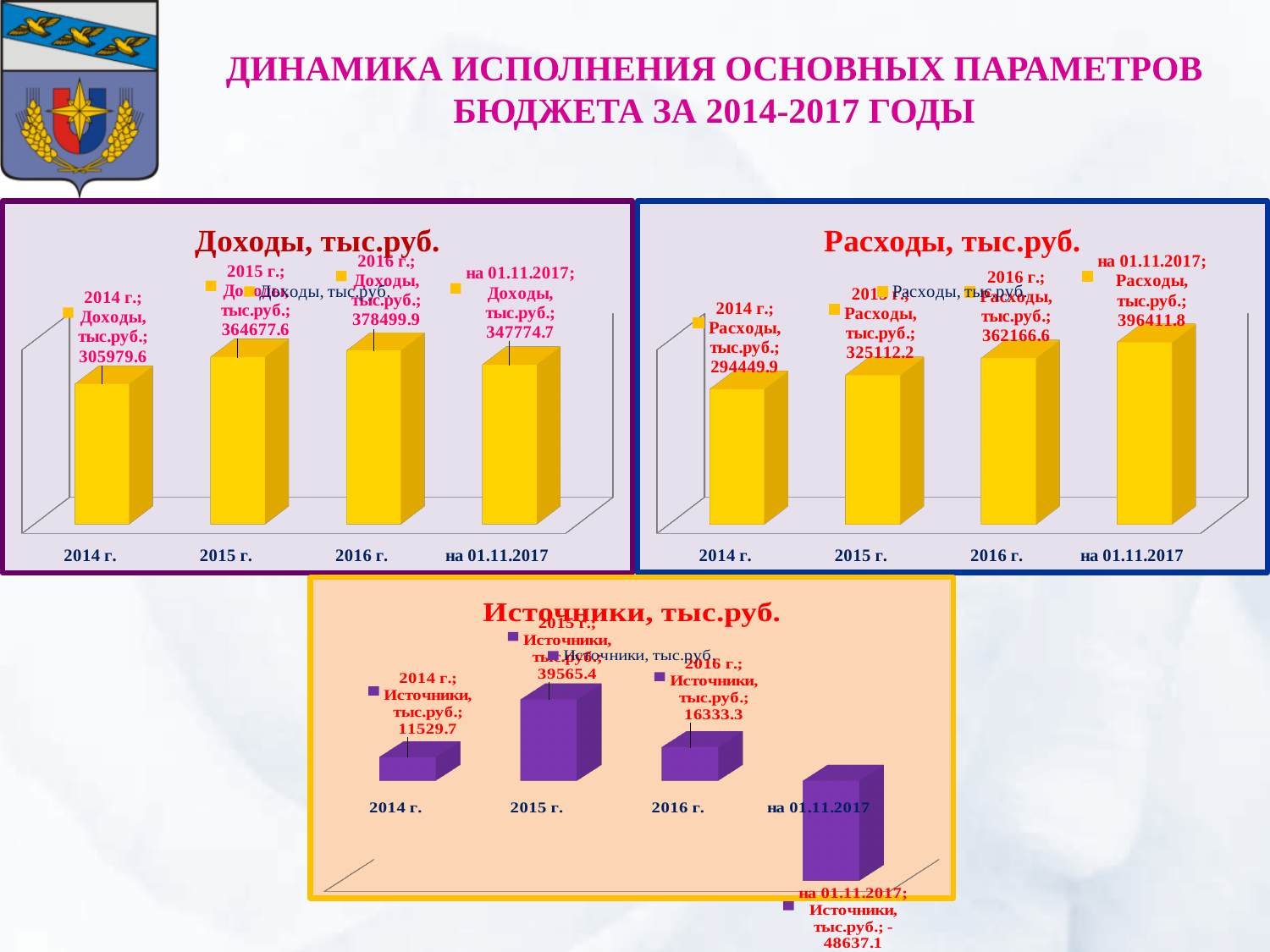
In the "Расходы, тыс.руб." chart, do the values rise or fall from 2014 г. to на 01.11.2017? rise In the "Доходы, тыс.руб." chart, what is the difference between the values for 2015 г. and 2014 г.? 58698.0 In the "Источники, тыс.руб." chart, which category has the highest value? 2015 г. In the "Доходы, тыс.руб." chart, which category has the lowest value? 2014 г. What kind of chart is the "Источники, тыс.руб." chart? bar chart In the "Расходы, тыс.руб." chart, which is larger, the value for 2015 г. or 2016 г.? 2016 г. In the "Доходы, тыс.руб." chart, which category has the highest value? 2016 г. In the "Доходы, тыс.руб." chart, what is the value for 2016 г.? 378499.9 In the "Расходы, тыс.руб." chart, how many categories are shown? 4 In the "Источники, тыс.руб." chart, what is the value for на 01.11.2017? -48637.1 In the "Расходы, тыс.руб." chart, what is the value for на 01.11.2017? 396411.8 In the "Источники, тыс.руб." chart, what is the value for 2015 г.? 39565.4